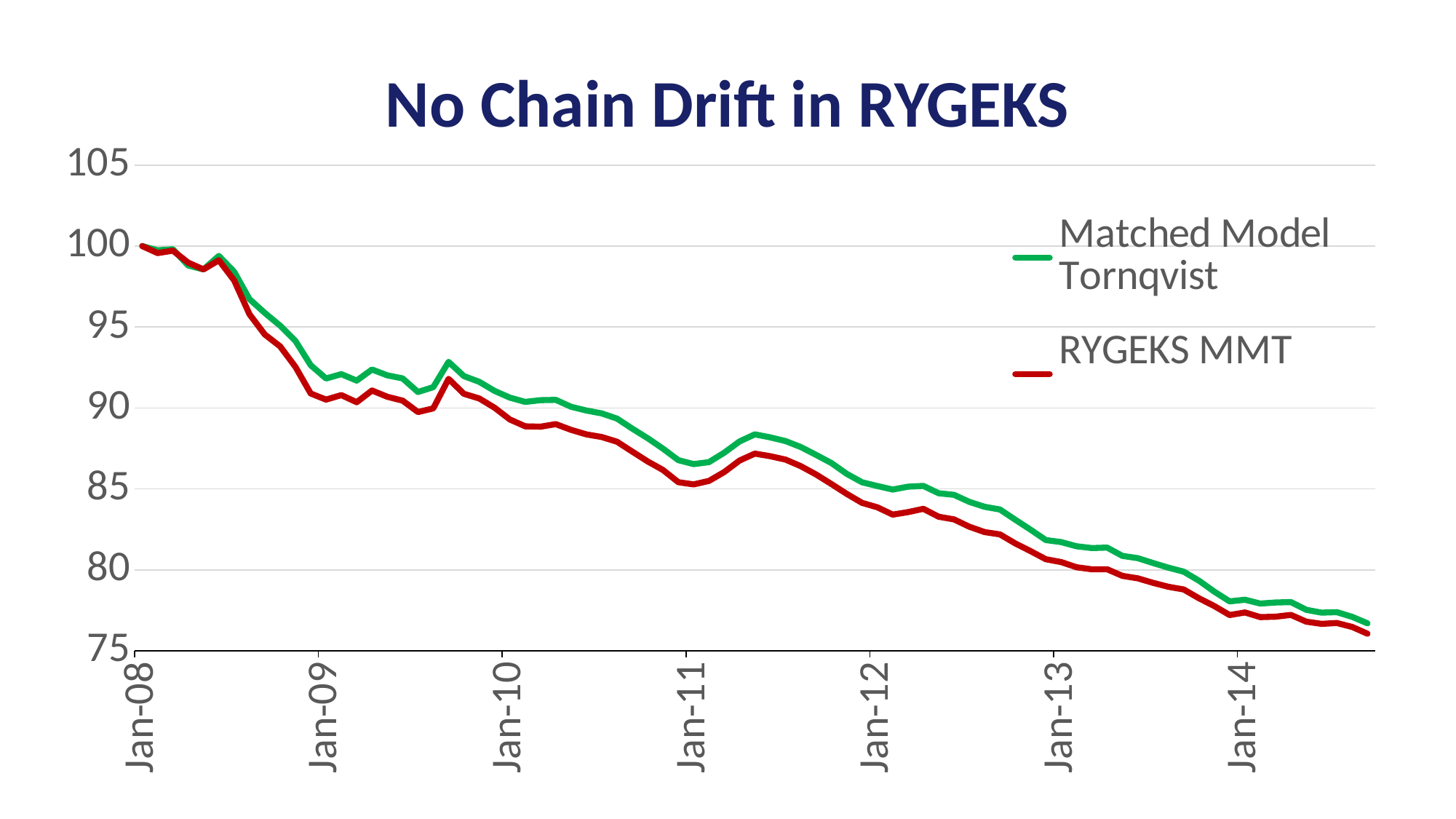
What is the title of the chart? No Chain Drift in RYGEKS Is the value for RYGEKS MMT at Jan-12 greater or less than 85? less Is the value for Matched Model Tornqvist at Jan-09 greater or less than 95? less Is the value for Matched Model Tornqvist at Jan-14 greater or less than 80? less Do the values of the RYGEKS MMT series rise or fall from Jan-08 to Jan-14? fall What kind of chart is shown on the slide? line chart What is the value of the RYGEKS MMT series at Jan-08? 100 What colour is the RYGEKS MMT line? red What is the value of the Matched Model Tornqvist series at Jan-08? 100 At Jan-13, which series has the higher value, Matched Model Tornqvist or RYGEKS MMT? Matched Model Tornqvist How many series does the legend list? 2